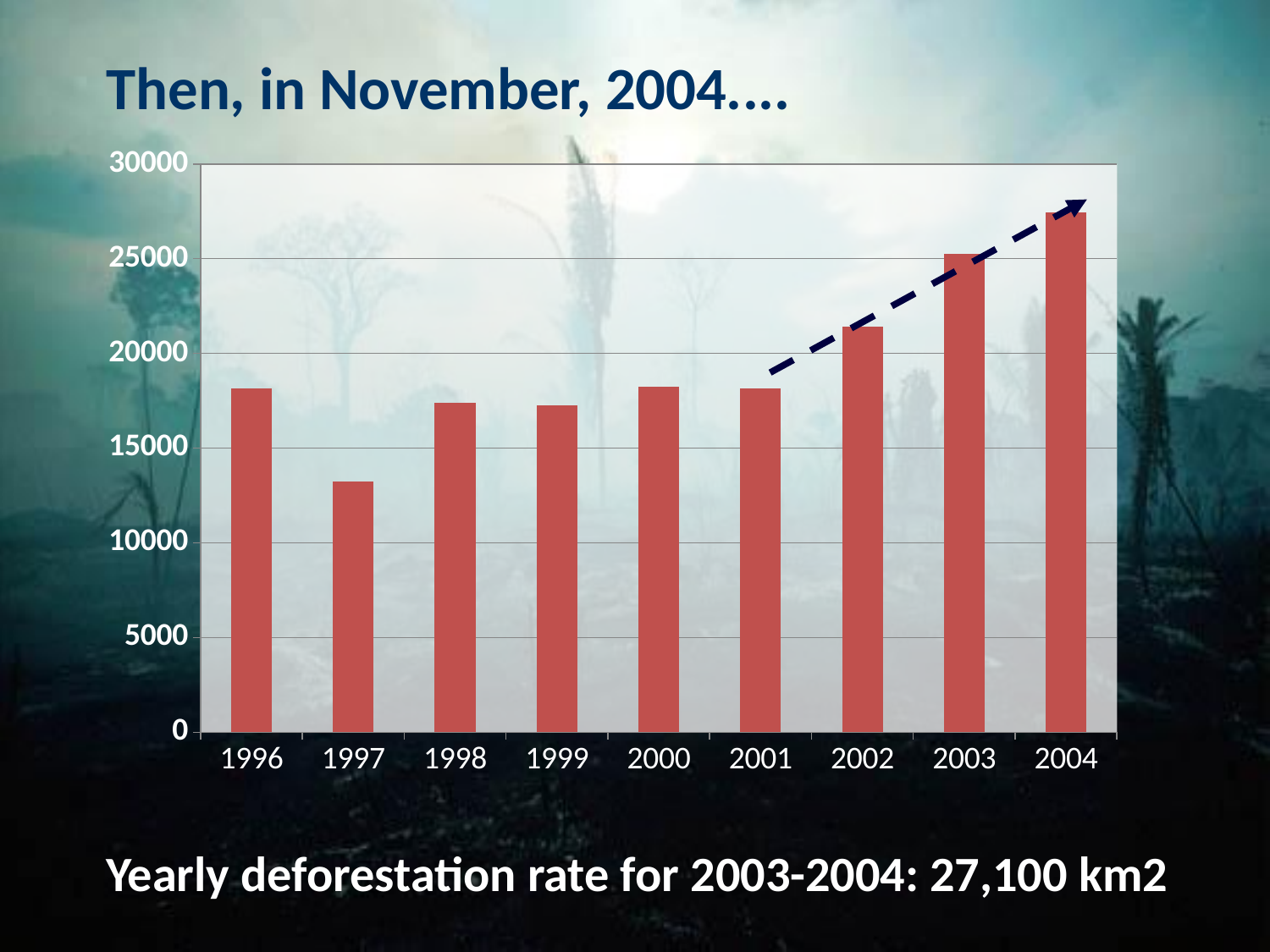
What is the title text at the top of the slide? Then, in November, 2004.... Is the value for 2004 greater or less than 25000? greater Which year has the lowest bar in the chart? 1997 What kind of chart is shown on the slide? bar chart Do the values rise or fall from 2001 to 2004? rise Which year has the highest bar in the chart? 2004 Which is larger, the value for 2003 or the value for 2002? 2003 Is the value for 1999 greater or less than 20000? less Is the value for 1997 greater or less than 15000? less Which is larger, the value for 1996 or the value for 1997? 1996 How many years are shown on the x axis of the chart? 9